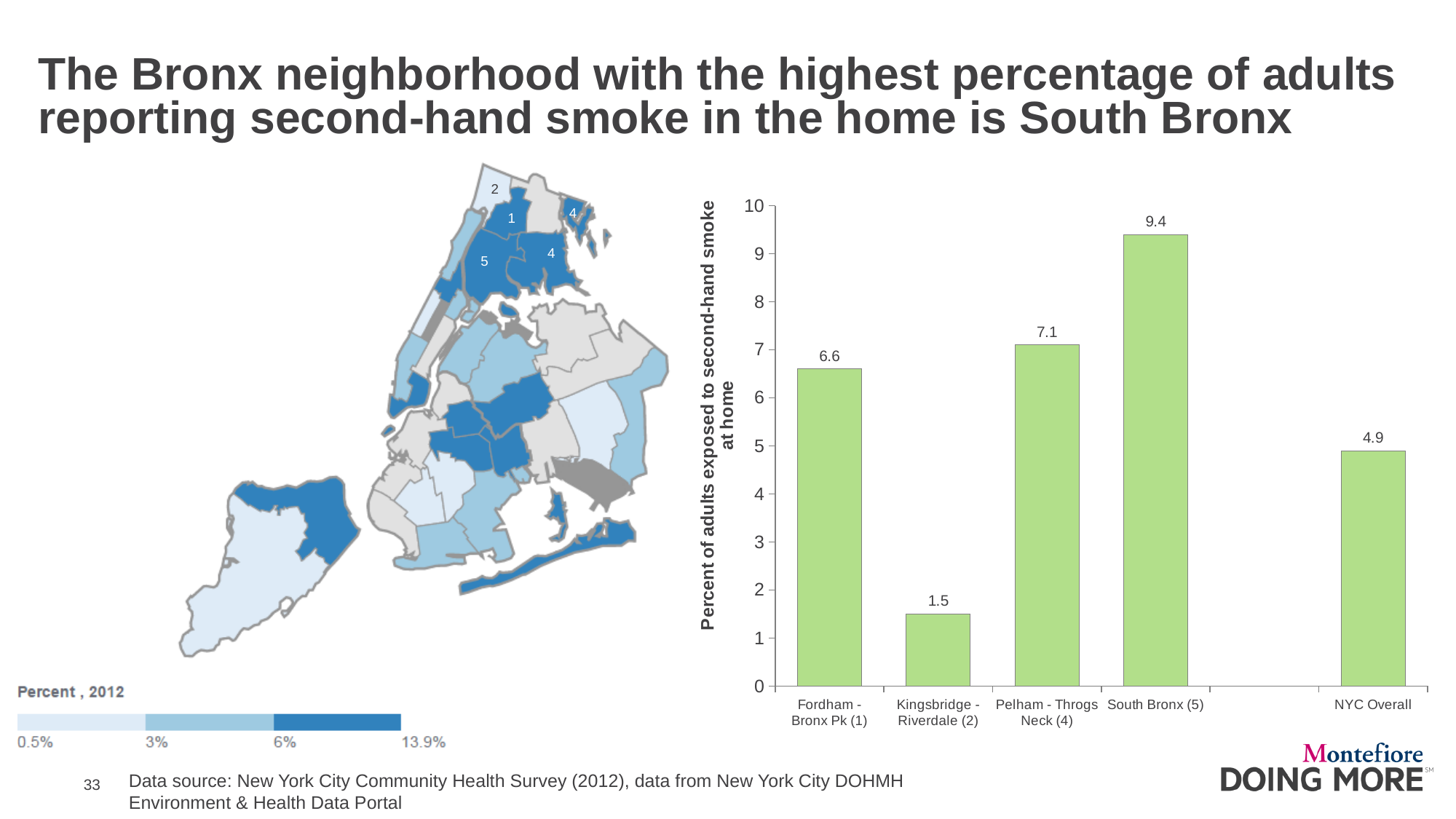
What is the difference between the values for South Bronx (5) and NYC Overall in the bar chart? 4.5 Which category has the lowest value in the bar chart? Kingsbridge - Riverdale (2) What kind of chart is shown on the right side of the slide? Bar chart How many bars are plotted in the bar chart? 5 What is the value for Fordham - Bronx Pk (1) in the bar chart? 6.6 What is the value for NYC Overall in the bar chart? 4.9 What is the y-axis label of the bar chart? Percent of adults exposed to second-hand smoke at home Which is larger in the bar chart, the value for Fordham - Bronx Pk (1) or the value for NYC Overall? Fordham - Bronx Pk (1) What is the difference between the values for Pelham - Throgs Neck (4) and Fordham - Bronx Pk (1) in the bar chart? 0.5 What is the value for Kingsbridge - Riverdale (2) in the bar chart? 1.5 Which category has the highest value in the bar chart? South Bronx (5) What is the value for South Bronx (5) in the bar chart? 9.4